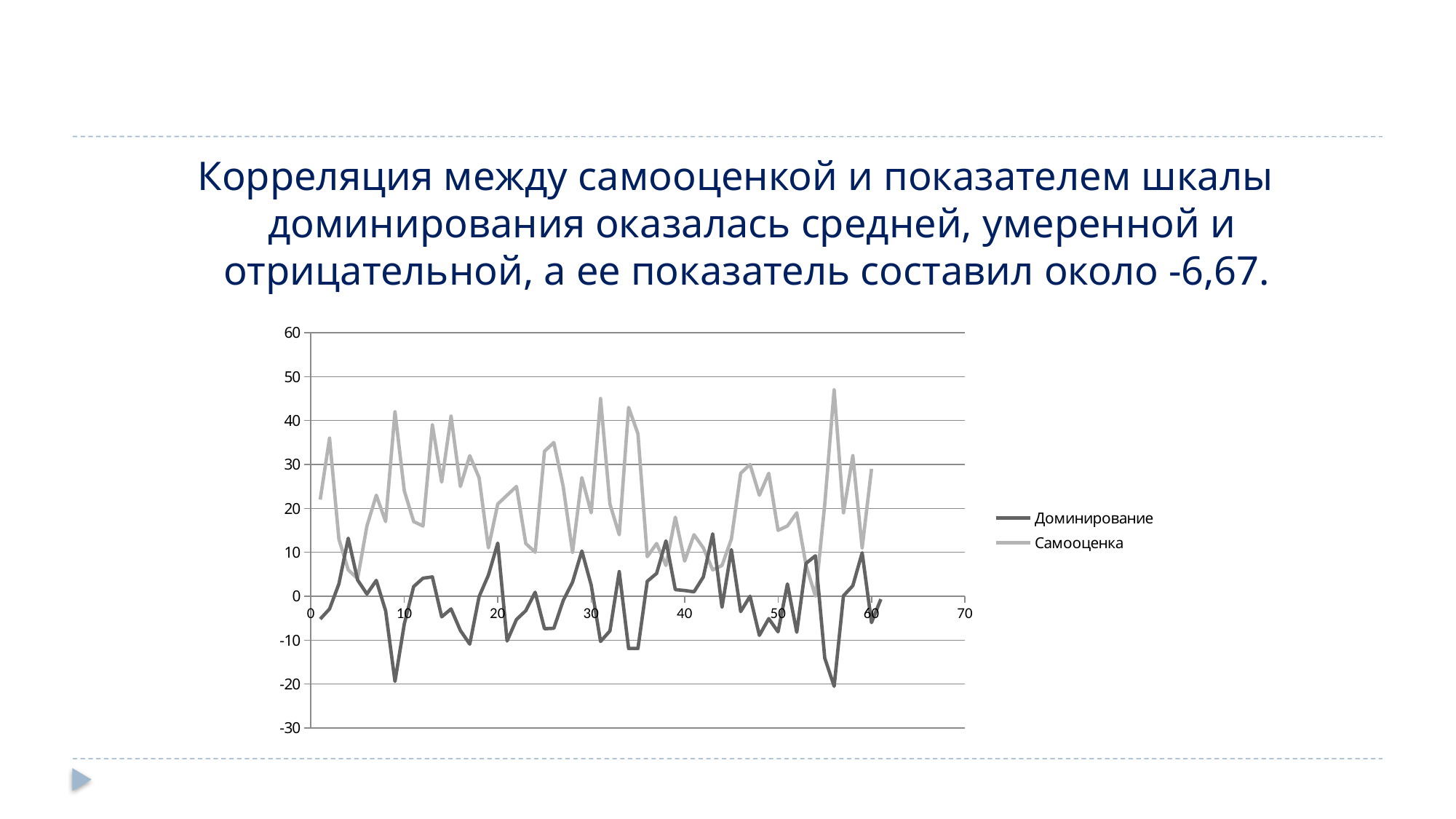
Is the lowest value of the Доминирование series greater or less than -10? less Which series is drawn with the darker line, Доминирование or Самооценка? Доминирование What are the two series named in the chart legend? Доминирование and Самооценка Is the highest value of the Доминирование series greater or less than 20? less What kind of chart is shown on the slide? line chart How many series does the chart legend list? 2 Is the highest value of the Самооценка series greater or less than 40? greater What is the highest value shown on the vertical axis of the chart? 60 Which series generally has higher values across the chart, Доминирование or Самооценка? Самооценка Around x = 9, which series has the larger value, Доминирование or Самооценка? Самооценка